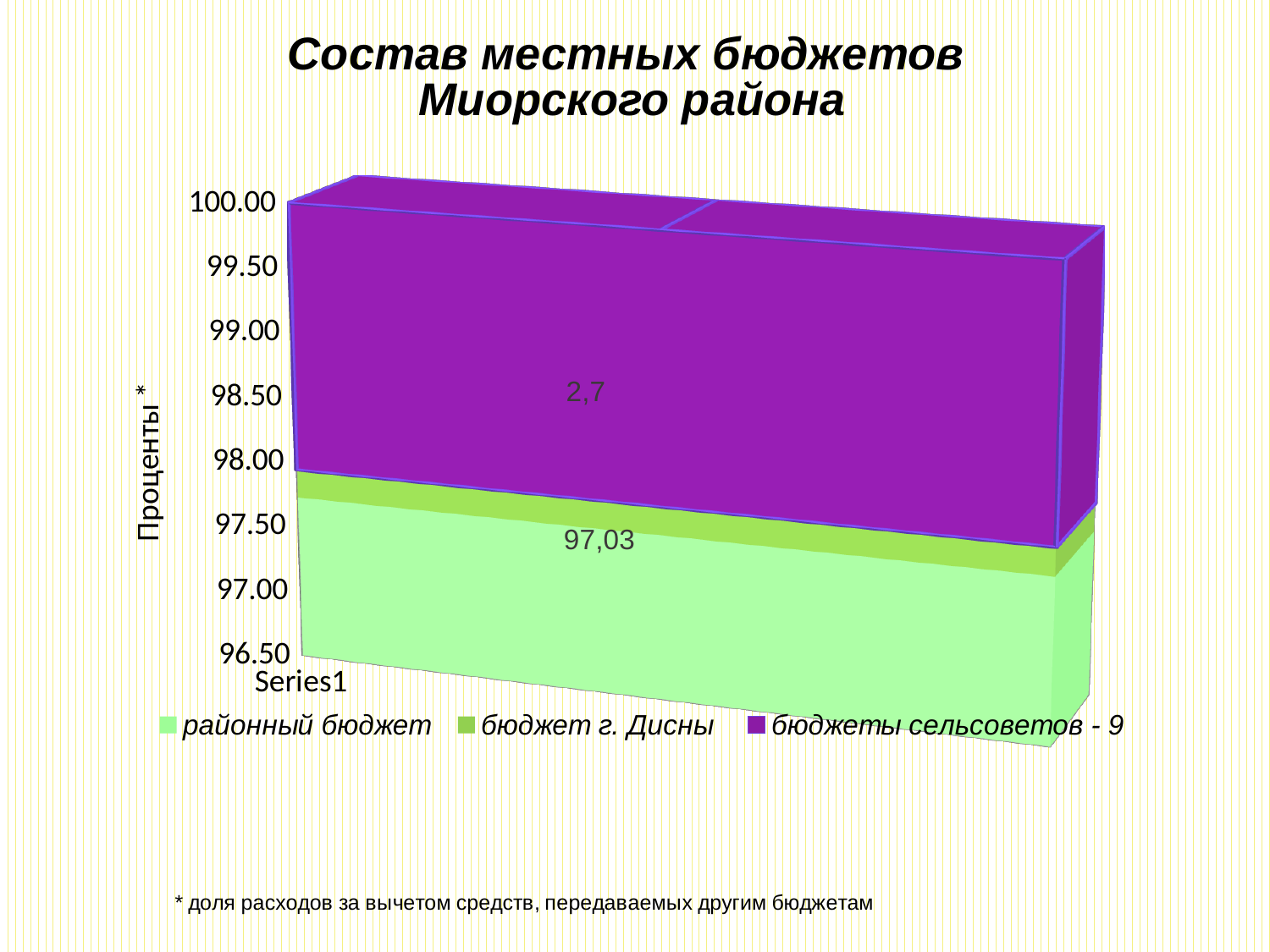
What is the difference between the value for 'районный бюджет' and the value for 'бюджеты сельсоветов - 9'? 94,33 What value is labelled for the series 'районный бюджет'? 97,03 What is the title of the chart? Состав местных бюджетов Миорского района How many series does the legend list? 3 What is the label of the y axis? Проценты * Which series has the largest value? районный бюджет What value is labelled for the series 'бюджеты сельсоветов - 9'? 2,7 Which series has the smallest value? бюджет г. Дисны What kind of chart is shown on the slide? area chart Which is larger: the value for 'районный бюджет' or the value for 'бюджеты сельсоветов - 9'? районный бюджет